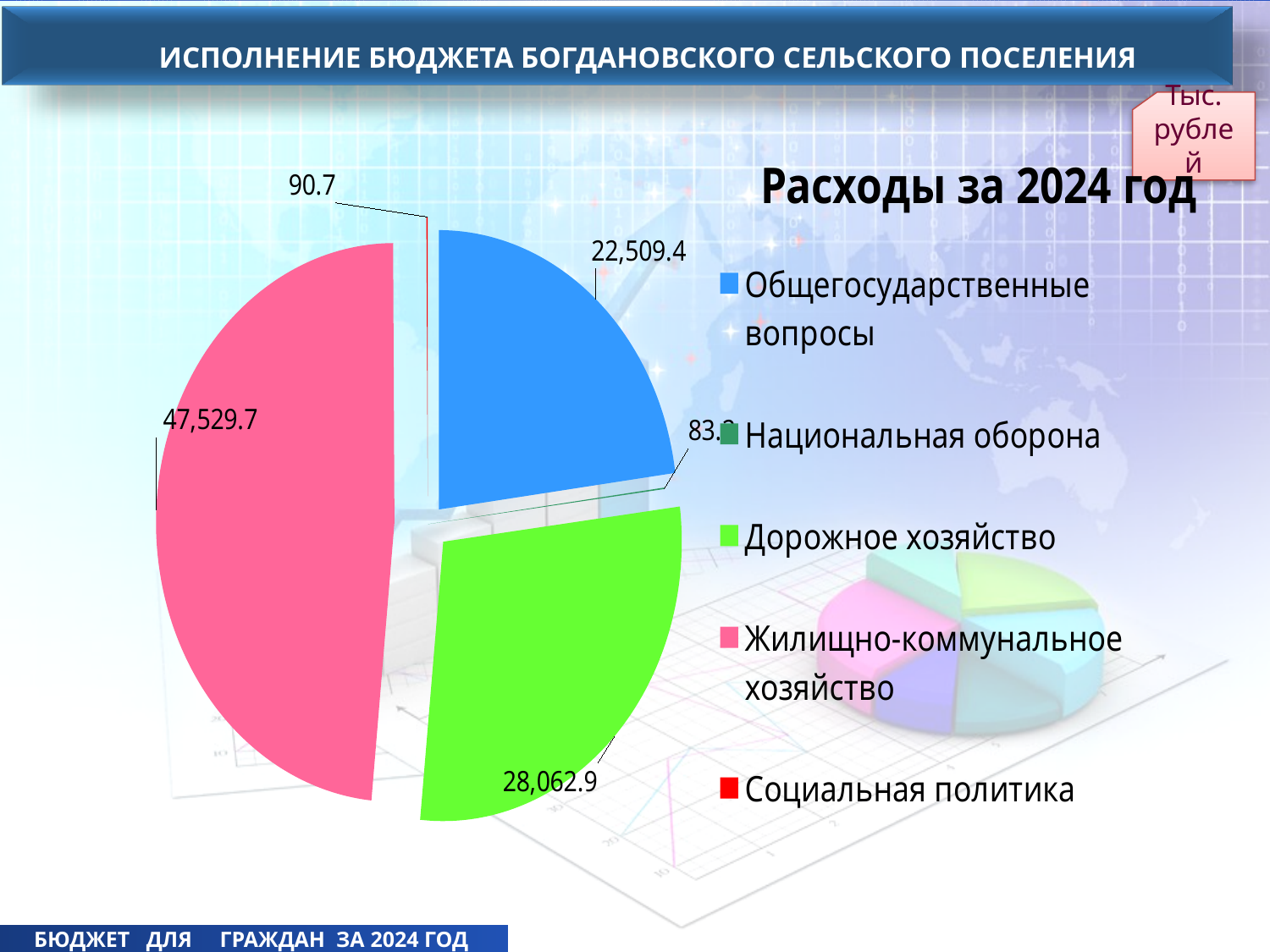
Which category has the largest slice in the pie chart? Жилищно-коммунальное хозяйство What is the title of the pie chart? Расходы за 2024 год Which category has the smallest slice in the pie chart? Национальная оборона What is the difference between Жилищно-коммунальное хозяйство and Общегосударственные вопросы? 25,020.3 What is the value for Социальная политика in the pie chart? 90.7 What is the value for Дорожное хозяйство in the pie chart? 28,062.9 What kind of chart is shown on the slide? pie chart What is the value for Жилищно-коммунальное хозяйство in the pie chart? 47,529.7 What is the value for Общегосударственные вопросы in the pie chart? 22,509.4 How many categories does the legend of the pie chart list? 5 Which is larger, Дорожное хозяйство or Общегосударственные вопросы? Дорожное хозяйство What is the difference between Дорожное хозяйство and Общегосударственные вопросы? 5,553.5